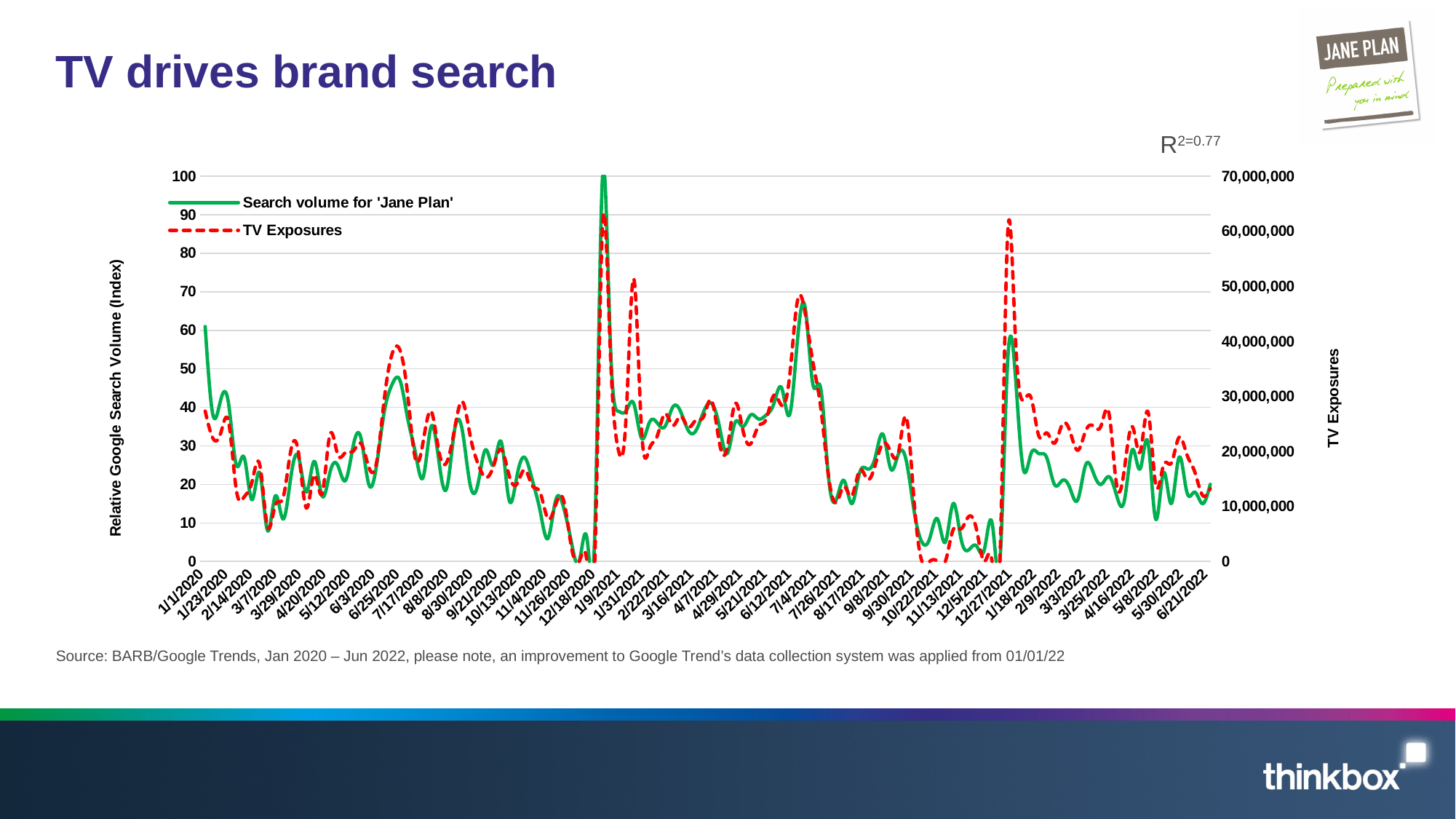
Is the TV Exposures value around 10/22/2021 greater or less than 10,000,000? less Is the search volume for 'Jane Plan' around 10/22/2021 greater or less than 20? less What R-squared value is shown above the chart? R2=0.77 What kind of chart is shown on the slide? Line chart Does the search volume for 'Jane Plan' rise or fall between 1/1/2020 and 3/7/2020? Fall Is the search volume for 'Jane Plan' at 1/1/2020 greater or less than 50? greater What is the title of the slide's chart? TV drives brand search What is the highest value reached by the 'Search volume for Jane Plan' series on the left axis? 100 Which is higher for the search volume for 'Jane Plan': the value at 1/1/2020 or the value at 6/21/2022? 1/1/2020 How many series does the chart's legend list? 2